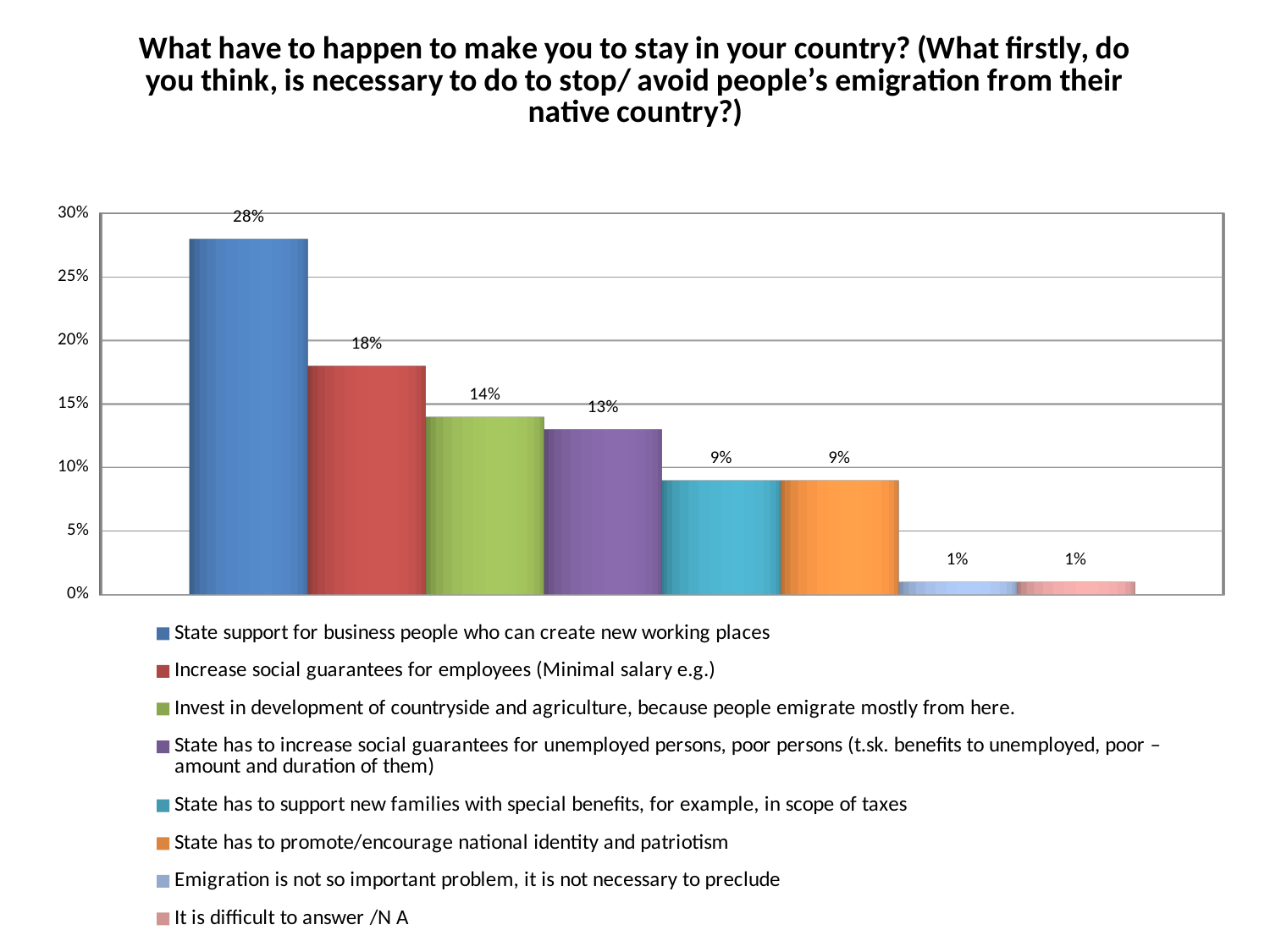
What is the value for "It is difficult to answer /N A"? 1% What is the value for "Increase social guarantees for employees (Minimal salary e.g.)"? 18% What is the difference between the value for "State support for business people who can create new working places" and the value for "Increase social guarantees for employees (Minimal salary e.g.)"? 10% How many bars are plotted in the chart? 8 Is the value for "State has to increase social guarantees for unemployed persons, poor persons" greater or less than 10%? greater What is the value for "Invest in development of countryside and agriculture, because people emigrate mostly from here."? 14% How many entries does the legend list? 8 What is the value for "State support for business people who can create new working places"? 28% Which response has the highest value? State support for business people who can create new working places What kind of chart is shown on the slide? Bar chart Which is larger: the value for "Invest in development of countryside and agriculture, because people emigrate mostly from here." or the value for "State has to support new families with special benefits, for example, in scope of taxes"? Invest in development of countryside and agriculture, because people emigrate mostly from here. What is the value for "State has to promote/encourage national identity and patriotism"? 9%